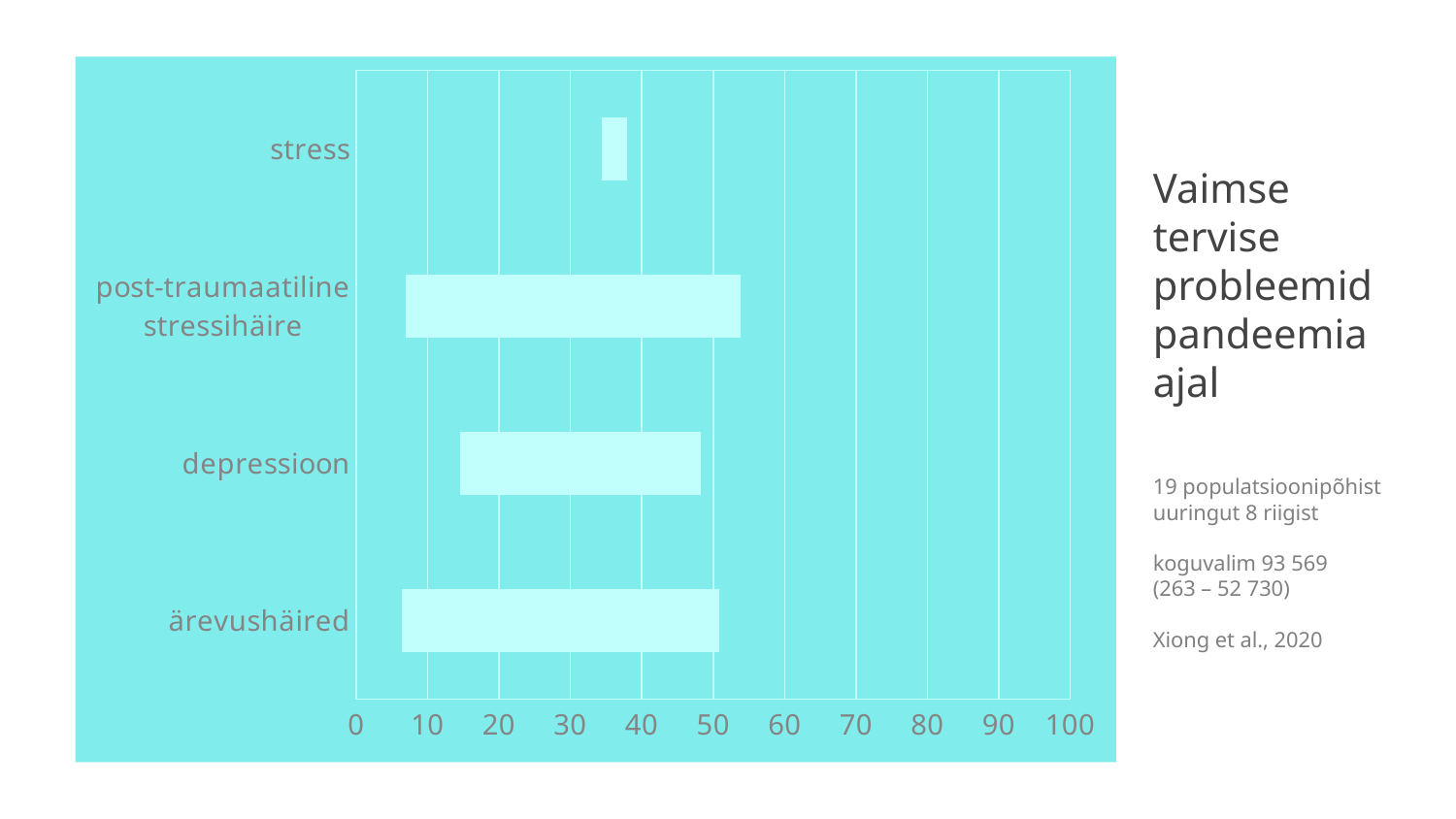
Is the left end of the ärevushäired bar greater or less than 10? less Is the right end of the depressioon bar greater or less than 50? less How many categories are plotted on the chart? 4 Which category has the narrowest bar on the chart? stress Which category's bar extends furthest to the right on the chart? post-traumaatiline stressihäire Is the right end of the post-traumaatiline stressihäire bar greater or less than 50? greater What is the highest value shown on the x axis of the chart? 100 What is the title text next to the chart on the slide? Vaimse tervise probleemid pandeemia ajal What kind of chart is shown on the slide? bar chart Does the depressioon bar or the stress bar extend further to the right? depressioon